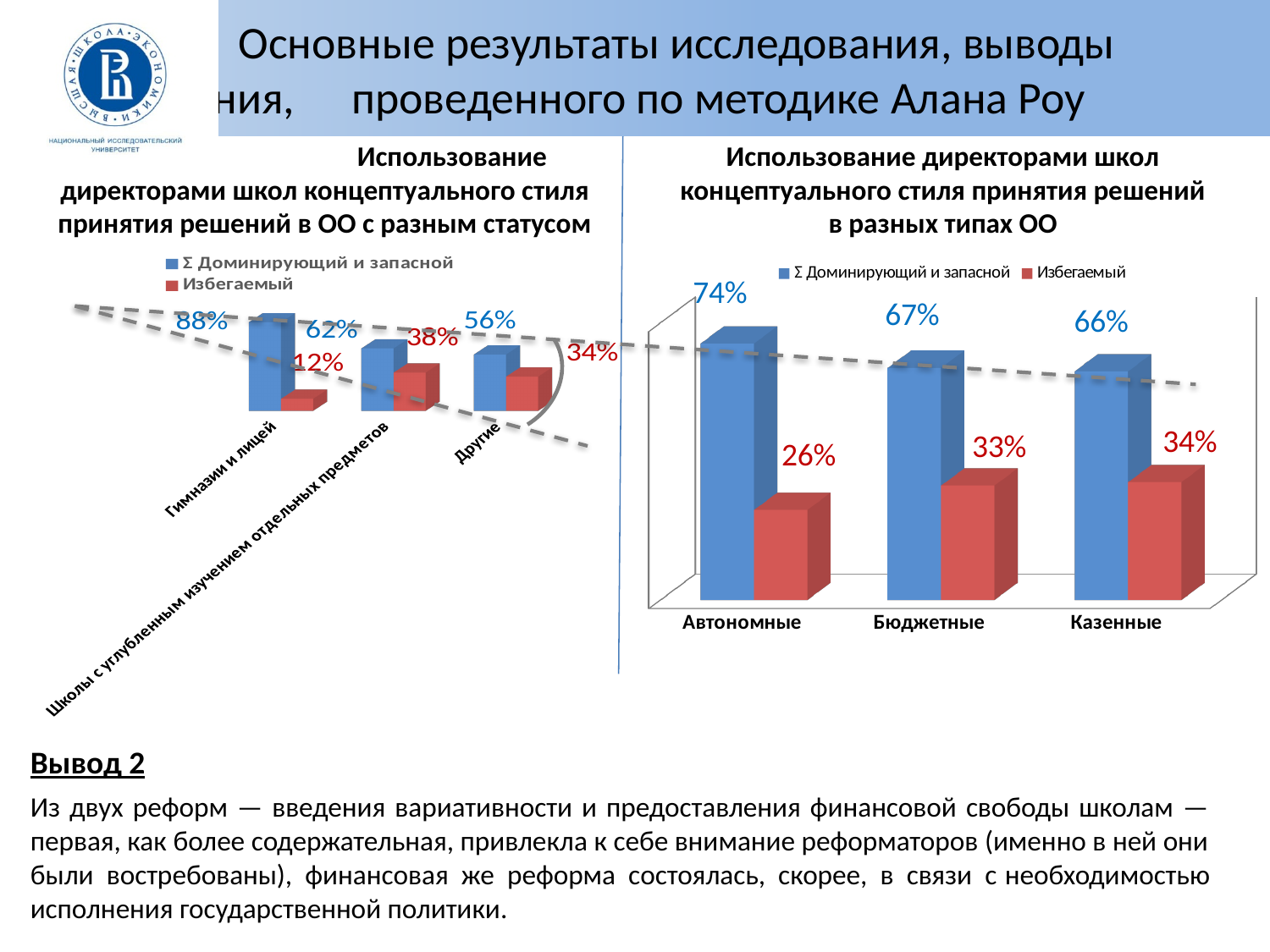
On the right chart, what is the difference between the 'Σ Доминирующий и запасной' values for Автономные and Казенные? 8% On the right chart, what is the value of 'Избегаемый' for Бюджетные? 33% On the right chart, which category has the highest value for 'Σ Доминирующий и запасной'? Автономные How many series does the legend of the right chart list? 2 On the left chart, what is the value of 'Избегаемый' for Школы с углубленным изучением отдельных предметов? 38% On the right chart (Использование директорами школ концептуального стиля принятия решений в разных типах ОО), what is the value of 'Σ Доминирующий и запасной' for Автономные? 74% On the right chart, does the 'Σ Доминирующий и запасной' series rise or fall from Автономные to Казенные? fall On the right chart, which category has the lowest value for 'Избегаемый'? Автономные On the right chart, how many categories are shown on the x axis? 3 On the right chart, what is the value of 'Избегаемый' for Казенные? 34% On the left chart, which is larger: 'Σ Доминирующий и запасной' for Гимназии и лицеи or for Другие? Гимназии и лицеи On the left chart (Использование директорами школ концептуального стиля принятия решений в ОО с разным статусом), what is the value of 'Σ Доминирующий и запасной' for Гимназии и лицеи? 88%